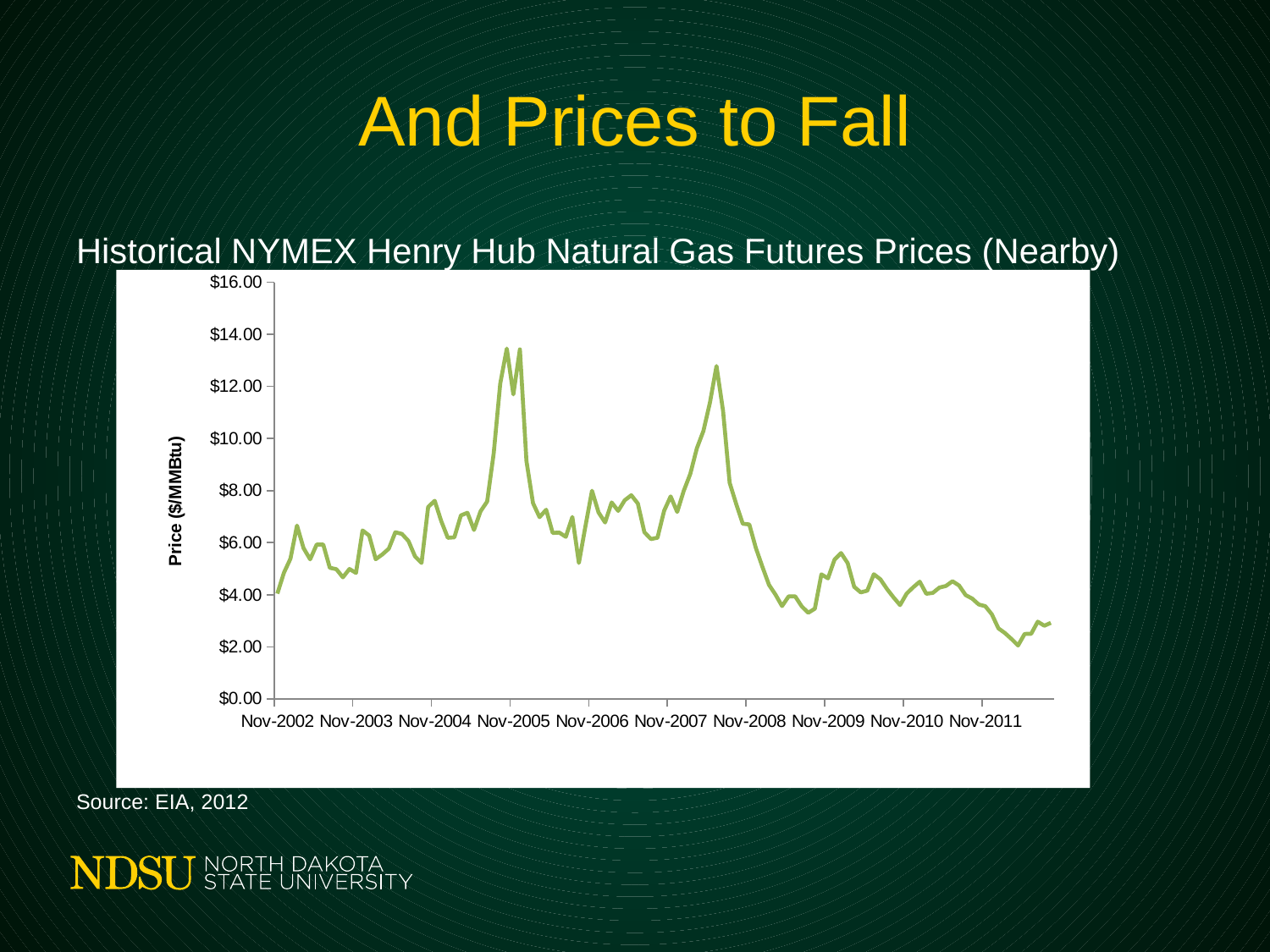
How many lines (data series) are plotted on the chart? 1 Is the peak reached in mid-2008 greater or less than $10.00? greater How many date labels are shown along the x axis of the chart? 10 What is the title of the chart? Historical NYMEX Henry Hub Natural Gas Futures Prices (Nearby) Is the price at Nov-2011 greater or less than $6.00? less Is the price at Nov-2002 greater or less than $6.00? less Which is higher: the price at Nov-2005 or the price at Nov-2011? Nov-2005 What kind of chart is shown on the slide? Line chart From the mid-2008 peak to the end of the chart, does the price generally rise or fall? fall What is the label on the vertical axis of the chart? Price ($/MMBtu)